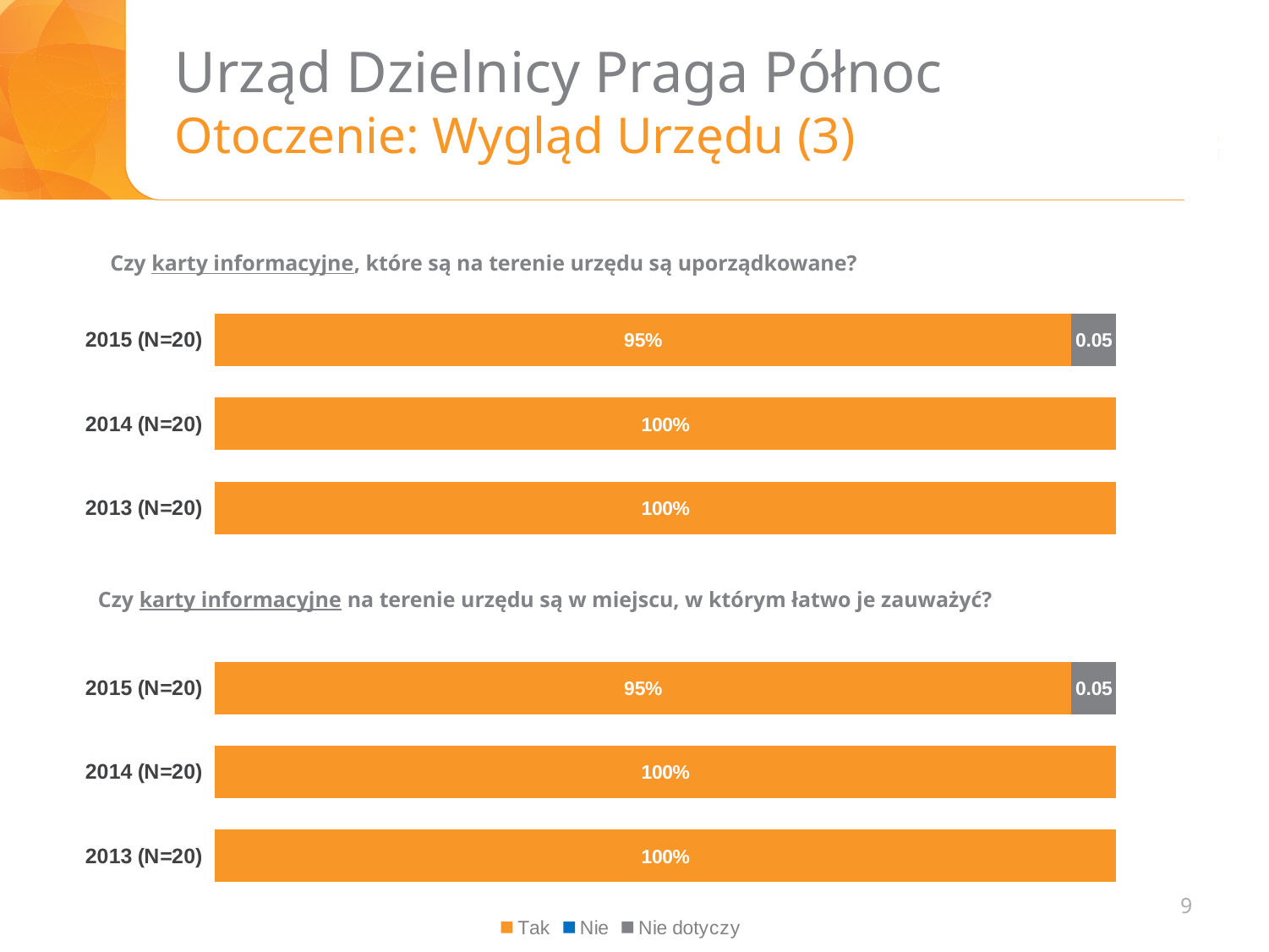
In the bottom chart ("Czy karty informacyjne na terenie urzędu są w miejscu, w którym łatwo je zauważyć?"), what is the value of "Tak" for 2015 (N=20)? 95% In the top chart ("Czy karty informacyjne, które są na terenie urzędu są uporządkowane?"), what is the value of "Tak" for 2014 (N=20)? 100% In the top chart ("Czy karty informacyjne, które są na terenie urzędu są uporządkowane?"), what value is printed on the grey segment for 2015 (N=20)? 0.05 In the top chart ("Czy karty informacyjne, które są na terenie urzędu są uporządkowane?"), what is the value of "Tak" for 2015 (N=20)? 95% In the bottom chart ("Czy karty informacyjne na terenie urzędu są w miejscu, w którym łatwo je zauważyć?"), which is larger, the "Tak" value for 2014 (N=20) or for 2015 (N=20)? 2014 (N=20) In the top chart ("Czy karty informacyjne, które są na terenie urzędu są uporządkowane?"), what is the difference between the "Tak" value for 2014 (N=20) and for 2015 (N=20)? 5% How many year categories does the bottom chart ("Czy karty informacyjne na terenie urzędu są w miejscu, w którym łatwo je zauważyć?") show? 3 What type of chart is the top chart ("Czy karty informacyjne, które są na terenie urzędu są uporządkowane?")? Stacked horizontal bar chart In the bottom chart ("Czy karty informacyjne na terenie urzędu są w miejscu, w którym łatwo je zauważyć?"), what is the value of "Tak" for 2013 (N=20)? 100% Which legend entry is shown in orange? Tak In the top chart ("Czy karty informacyjne, które są na terenie urzędu są uporządkowane?"), which year has the lowest "Tak" value? 2015 (N=20) How many series does the legend at the bottom of the slide list? 3